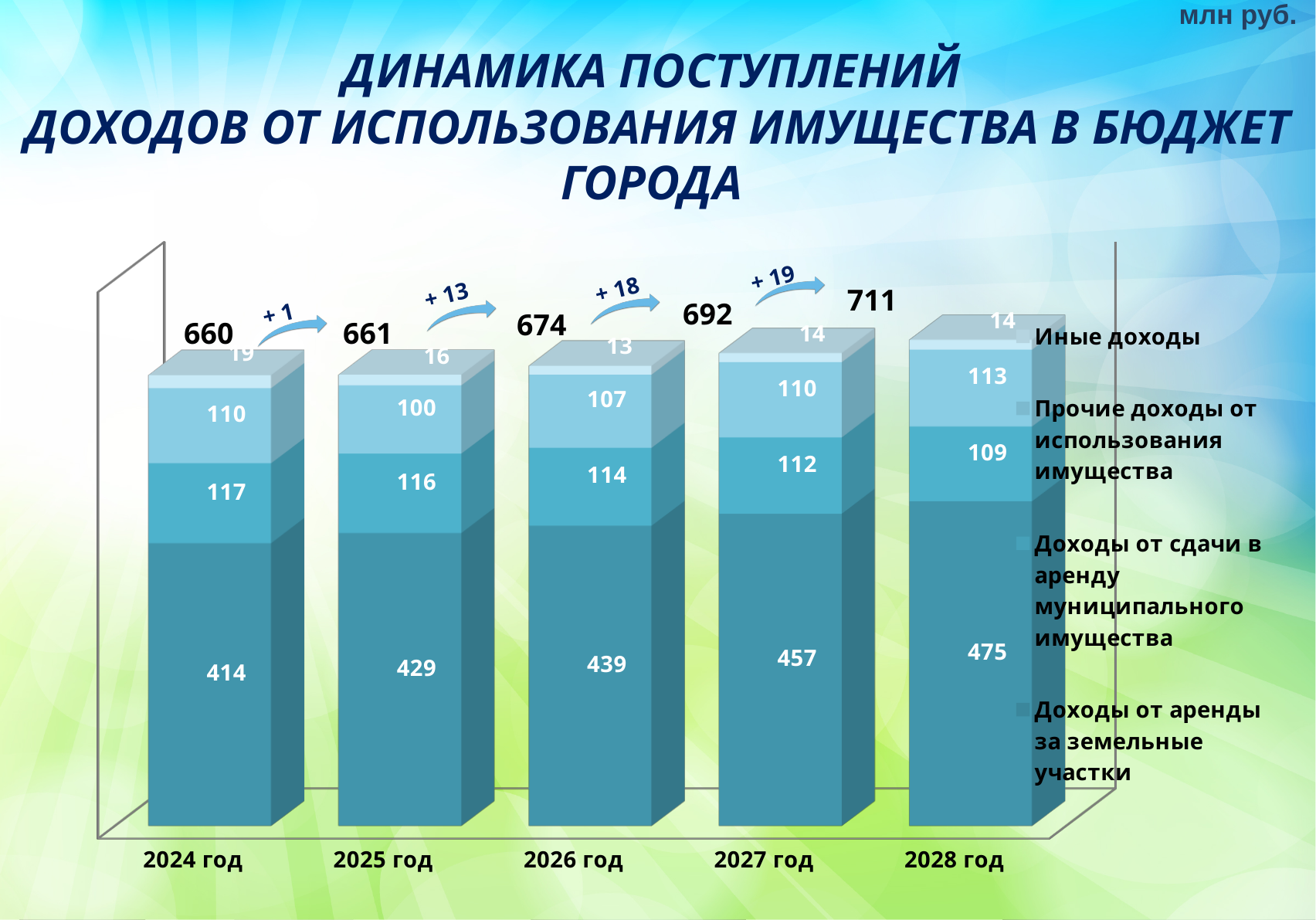
What is the value of 'Иные доходы' for 2025 год? 16 What is the value of 'Доходы от аренды за земельные участки' for 2024 год? 414 What is the total shown above the bar for 2027 год? 692 What is the value of 'Доходы от сдачи в аренду муниципального имущества' for 2026 год? 114 Which year has the highest total shown above its bar? 2028 год What is the difference between the 'Доходы от аренды за земельные участки' values for 2028 год and 2024 год? 61 Which year has the lowest value for 'Доходы от аренды за земельные участки'? 2024 год Do the totals shown above the bars rise or fall from 2024 год to 2028 год? rise How many years (categories) are shown on the x axis of the chart? 5 What type of chart is shown on the slide? stacked bar chart What is the value of 'Прочие доходы от использования имущества' for 2028 год? 113 How many series does the chart's legend list? 4